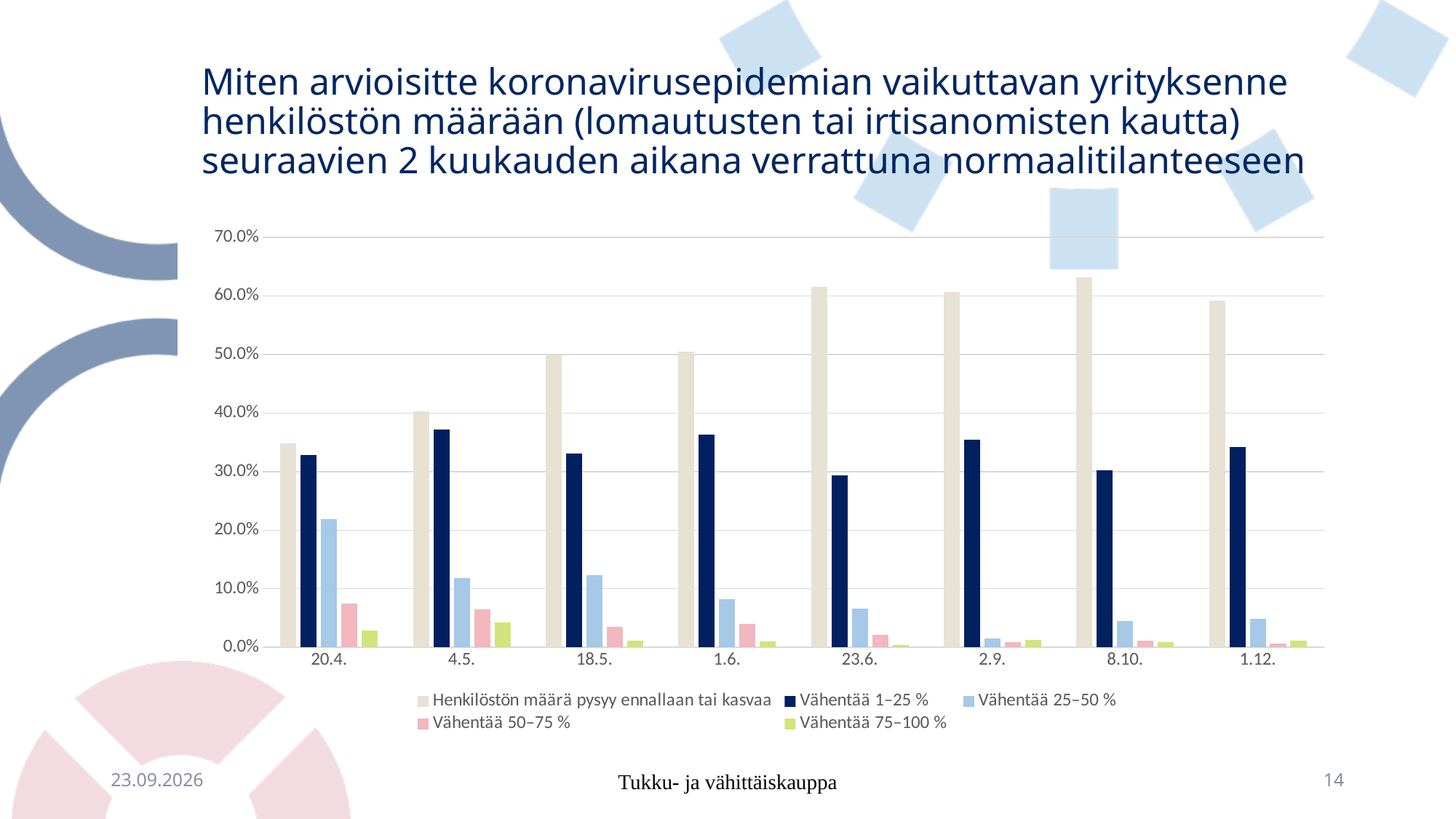
How many dates (categories) are shown on the x axis? 8 On which date is the value for 'Vähentää 25–50 %' highest? 20.4. On 23.6., which is larger: 'Henkilöstön määrä pysyy ennallaan tai kasvaa' or 'Vähentää 1–25 %'? Henkilöstön määrä pysyy ennallaan tai kasvaa What kind of chart is shown on the slide? bar chart On which date is the value for 'Henkilöstön määrä pysyy ennallaan tai kasvaa' lowest? 20.4. On which date is the value for 'Vähentää 25–50 %' lowest? 2.9. How many series does the legend list? 5 Is the value for 'Henkilöstön määrä pysyy ennallaan tai kasvaa' on 8.10. greater or less than 60.0%? greater Does the value for 'Vähentää 25–50 %' generally rise or fall from 20.4. to 1.12.? fall On which date is the value for 'Vähentää 75–100 %' highest? 4.5. Is the value for 'Vähentää 25–50 %' on 20.4. greater or less than 20.0%? greater Is the value for 'Henkilöstön määrä pysyy ennallaan tai kasvaa' on 20.4. greater or less than 40.0%? less